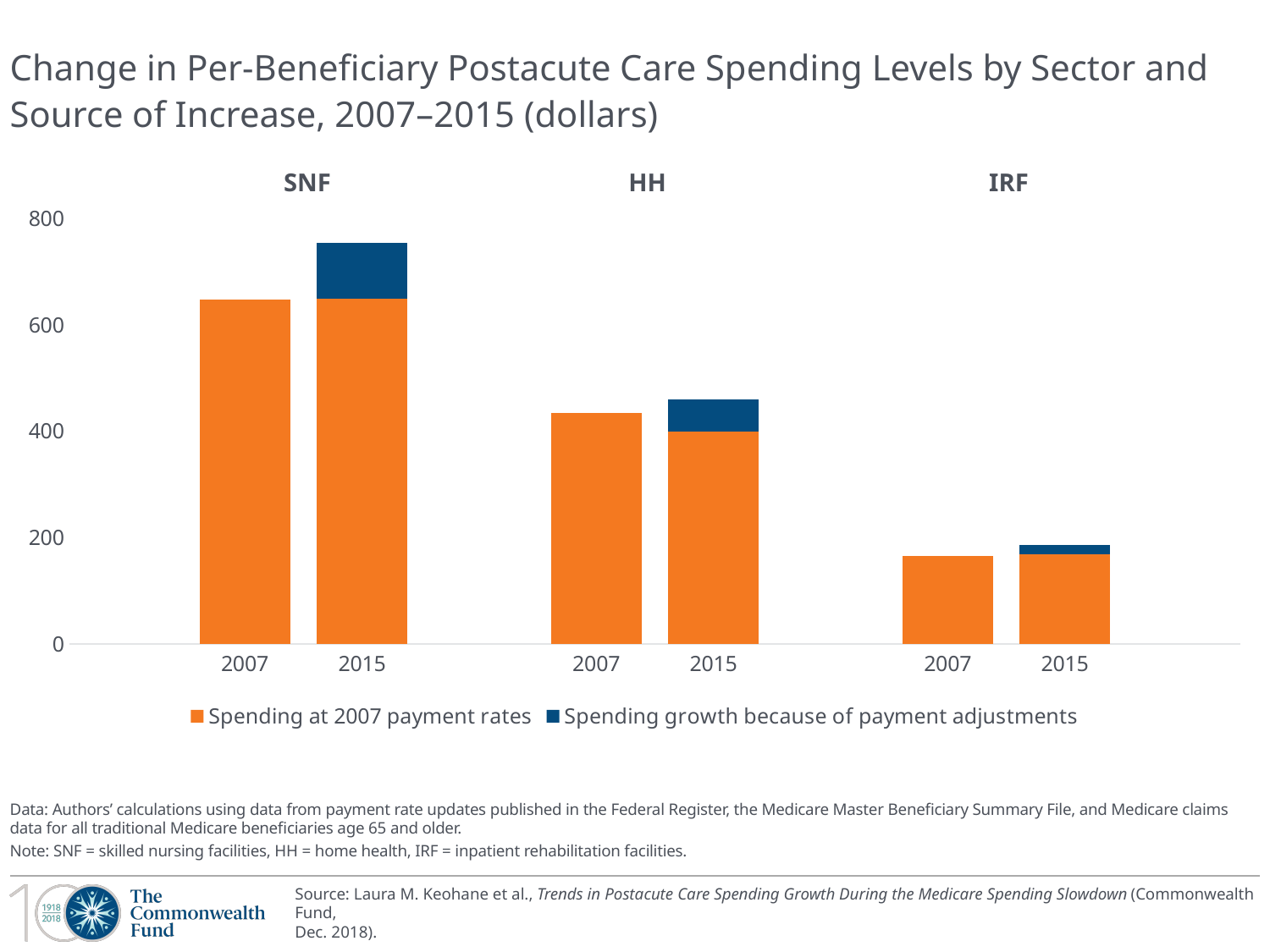
Is the value for IRF in 2007 greater or less than 200? less Which is larger, the total bar for SNF in 2015 or the total bar for HH in 2015? SNF 2015 Which bar is the shortest in the chart? IRF 2007 Is the total stacked value for SNF in 2015 greater or less than 700? greater How many bars are plotted in the chart? 6 How many series does the legend list? 2 What kind of chart is shown on the slide? Stacked bar chart Which sector has the largest 'Spending growth because of payment adjustments' segment? SNF Which series is shown in orange in the legend? Spending at 2007 payment rates Which bar is the tallest in the chart? SNF 2015 Is the value for HH in 2007 greater or less than 400? greater